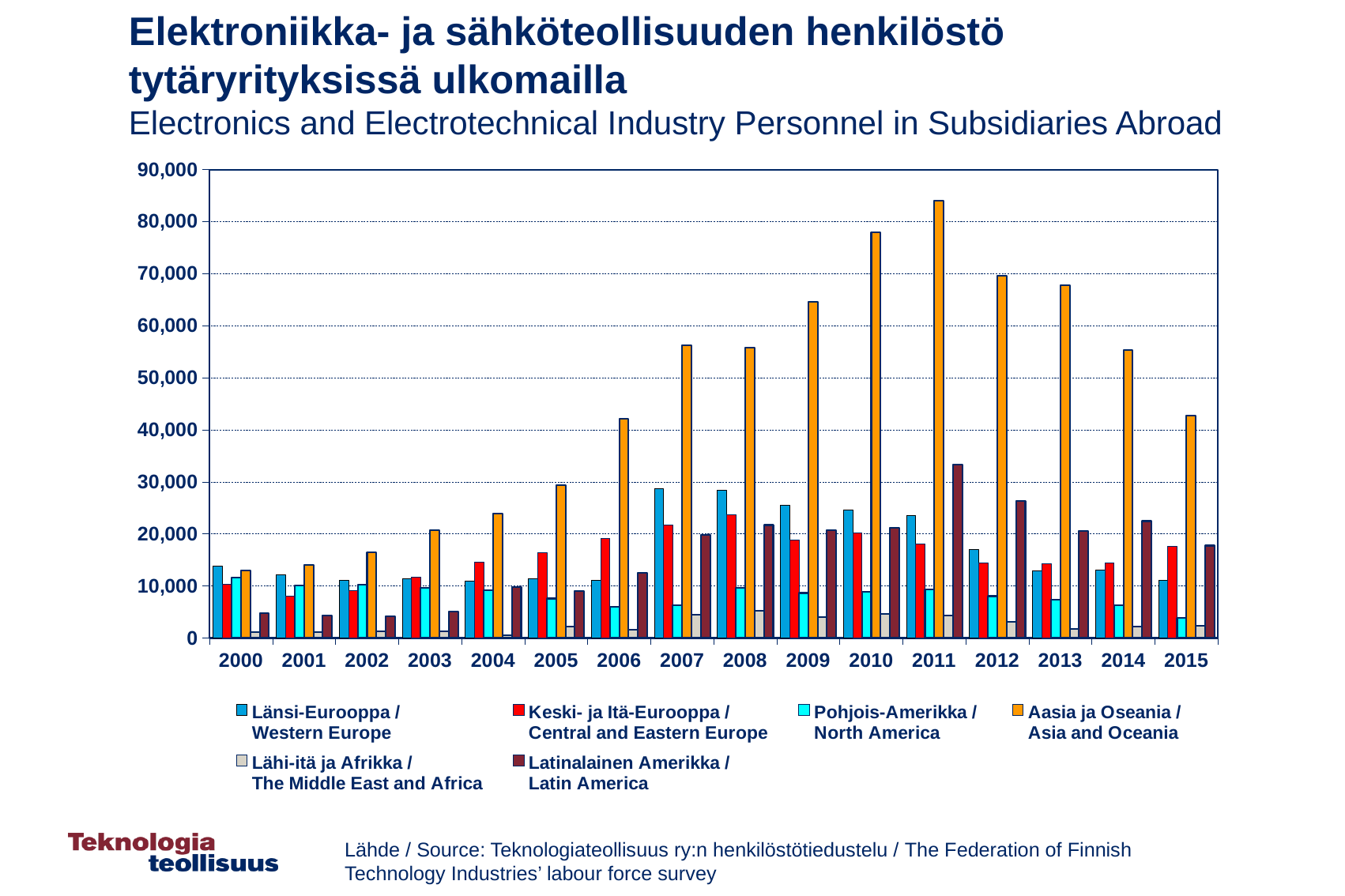
In which year is the value for Asia and Oceania the highest? 2011 What kind of chart is shown on the slide? bar chart How many series does the legend list? 6 What colour represents Asia and Oceania in the chart? orange Is the value for Asia and Oceania in 2010 greater or less than 70,000? greater Is the value for Western Europe in 2007 greater or less than 30,000? less Is the value for Asia and Oceania in 2011 greater or less than 80,000? greater How many years are shown on the x axis? 16 Do the values for Asia and Oceania rise or fall from 2000 to 2011? rise In 2011, which is larger: Asia and Oceania or Latin America? Asia and Oceania Which series has the lowest value in 2015? The Middle East and Africa